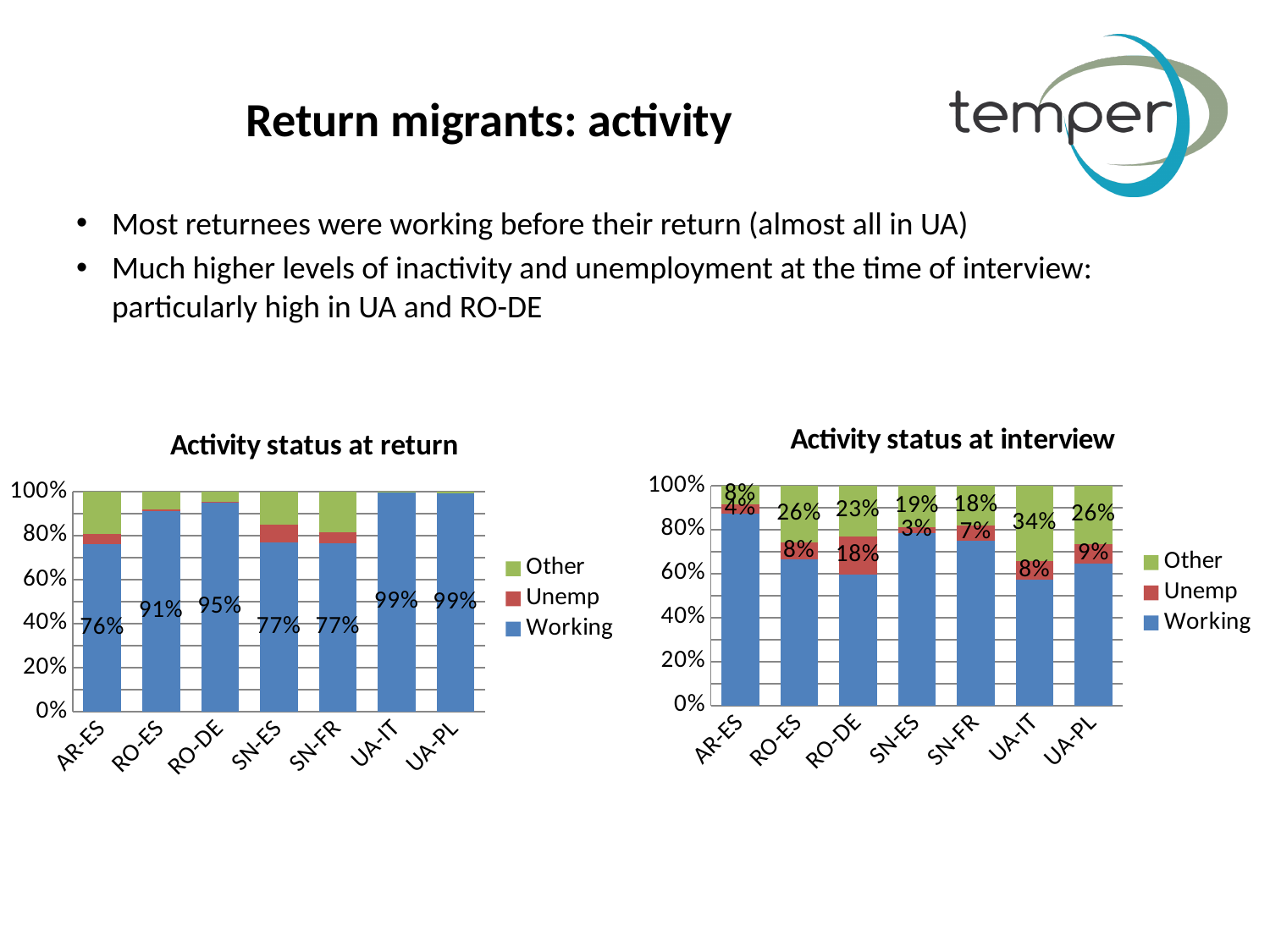
In the 'Activity status at return' chart, what is the difference between the Working shares of RO-DE and RO-ES? 4 percentage points In the 'Activity status at return' chart, which category has the lowest Working share? AR-ES In the 'Activity status at interview' chart, what is the Other share for UA-IT? 34% In the 'Activity status at interview' chart, which category has the highest Other share? UA-IT In the 'Activity status at interview' chart, which category has the lowest Unemp share? SN-ES How many series does the legend of the 'Activity status at interview' chart list? 3 In the 'Activity status at interview' chart, what is the Unemp share for RO-DE? 18% In the 'Activity status at interview' chart, is the Working share for AR-ES greater or less than 80%? greater In the 'Activity status at interview' chart, which has the larger Unemp share, RO-DE or RO-ES? RO-DE In the 'Activity status at return' chart, what is the Working share for AR-ES? 76% How many categories are shown on the x axis of the 'Activity status at return' chart? 7 In the 'Activity status at return' chart, what is the Working share for RO-DE? 95%